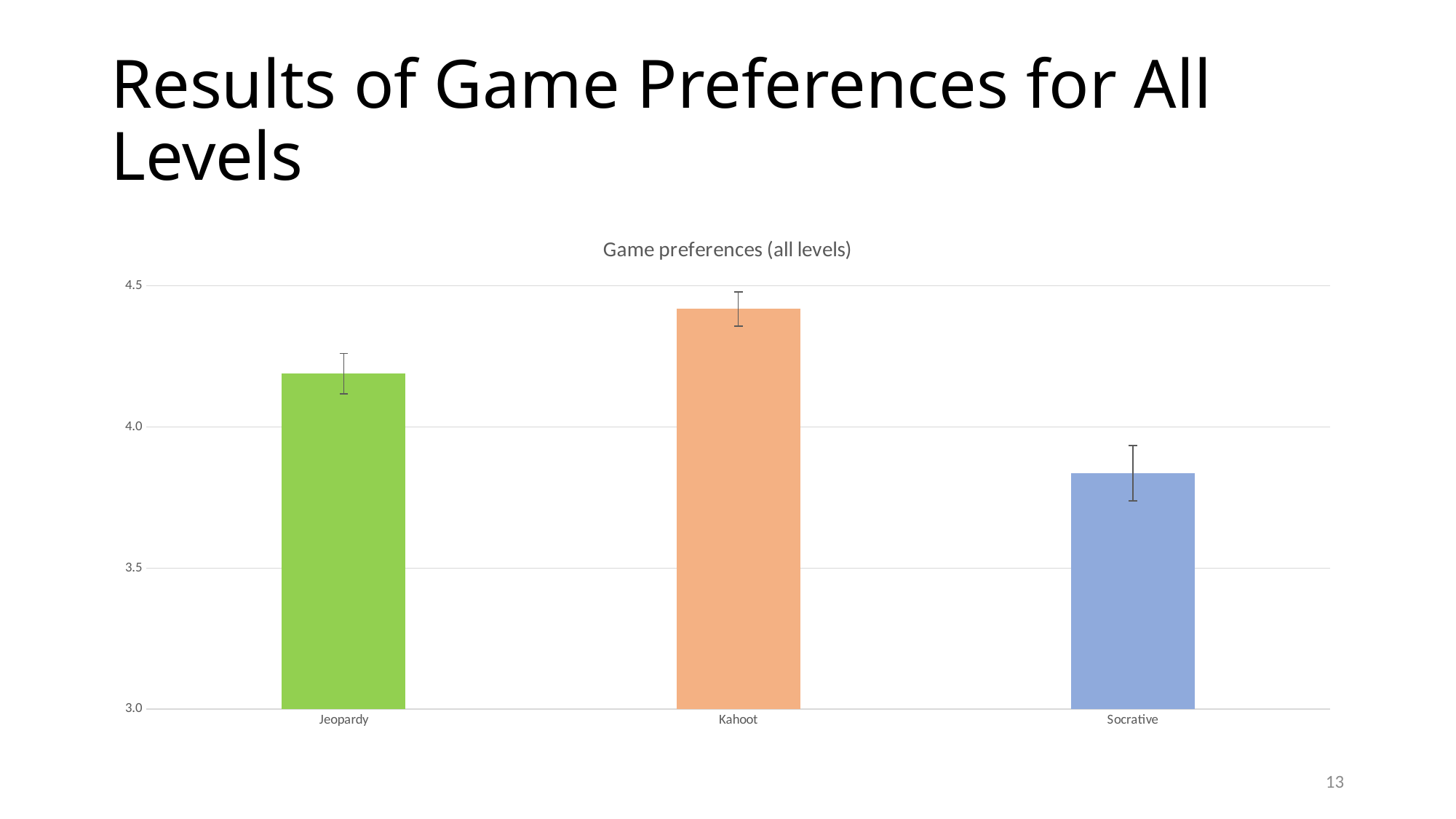
Is the value for Kahoot greater or less than 4.0? greater Which is larger, the value for Kahoot or the value for Jeopardy? Kahoot Which game has the highest preference value? Kahoot What colour is the bar for Kahoot? orange What kind of chart is shown on the slide? bar chart What is the title of the chart? Game preferences (all levels) Is the value for Jeopardy greater or less than 4.0? greater Which is larger, the value for Jeopardy or the value for Socrative? Jeopardy How many categories are shown on the x axis? 3 Is the value for Socrative greater or less than 3.5? greater Which game has the lowest preference value? Socrative